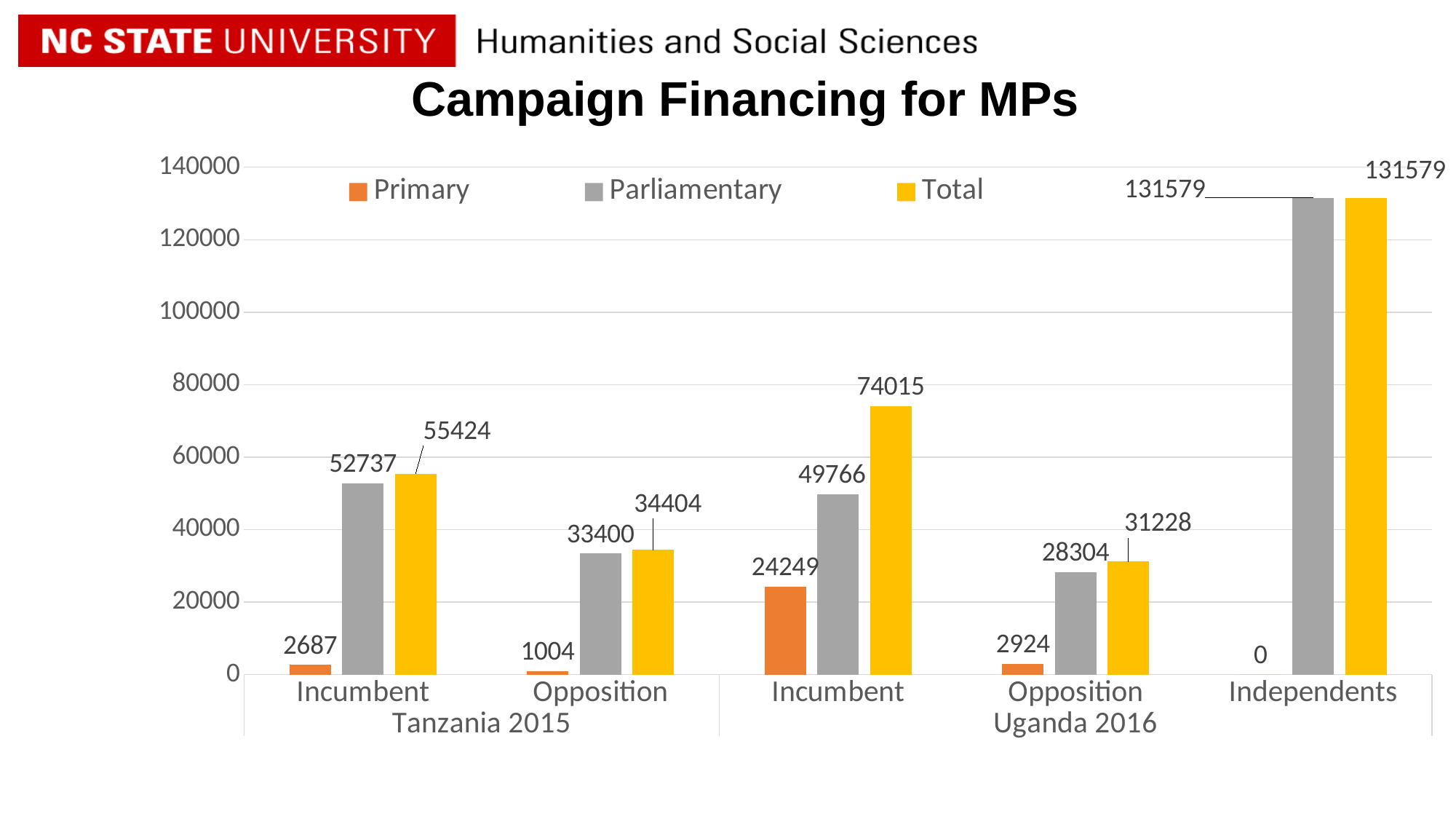
What is the title of the chart? Campaign Financing for MPs What is the difference between the Total and Parliamentary values for Incumbent in Uganda 2016? 24249 What is the Total value for Incumbent in Tanzania 2015? 55424 What is the Primary value for Incumbent in Uganda 2016? 24249 Which category has the highest Total value? Independents Which is larger: the Total for Opposition in Tanzania 2015 or the Total for Opposition in Uganda 2016? Opposition in Tanzania 2015 Which category has the lowest Primary value? Independents Is the Parliamentary value for Incumbent in Tanzania 2015 greater or less than 40000? greater What kind of chart is shown on the slide? bar chart What is the Primary value for Independents in Uganda 2016? 0 How many series does the legend list? 3 What is the Parliamentary value for Opposition in Tanzania 2015? 33400